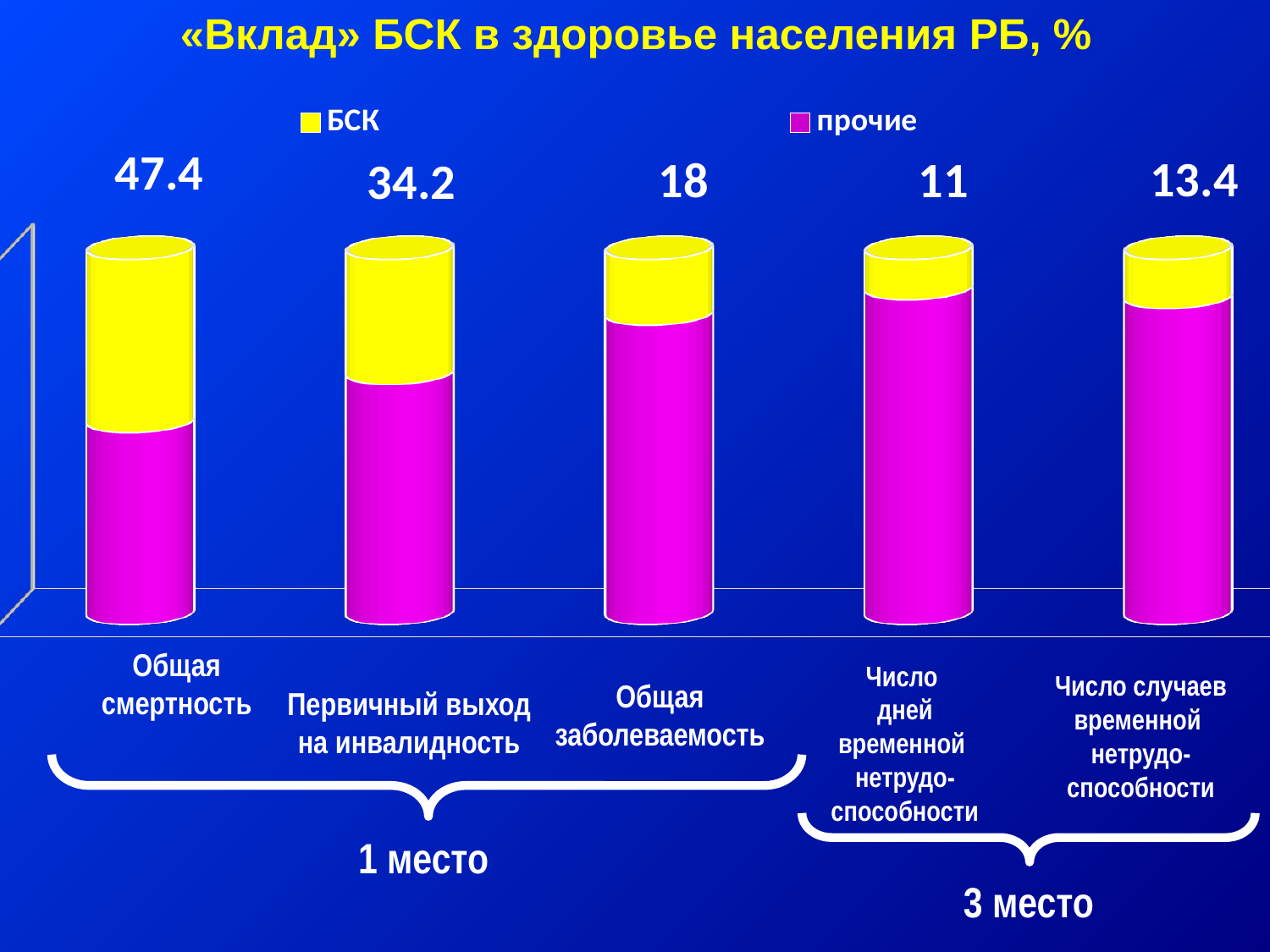
What is the БСК value for Общая заболеваемость? 18 What is the БСК value for Число дней временной нетрудоспособности? 11 What is the БСК value for Число случаев временной нетрудоспособности? 13.4 What is the БСК value for Общая смертность? 47.4 How many categories are shown in the chart? 5 How many series does the legend list? 2 Which category has the highest БСК value? Общая смертность Which has a larger БСК value: Общая заболеваемость or Число случаев временной нетрудоспособности? Общая заболеваемость What is the БСК value for Первичный выход на инвалидность? 34.2 Which category has the lowest БСК value? Число дней временной нетрудоспособности What is the difference between the БСК values for Общая смертность and Первичный выход на инвалидность? 13.2 What kind of chart is shown on the slide? Stacked bar chart